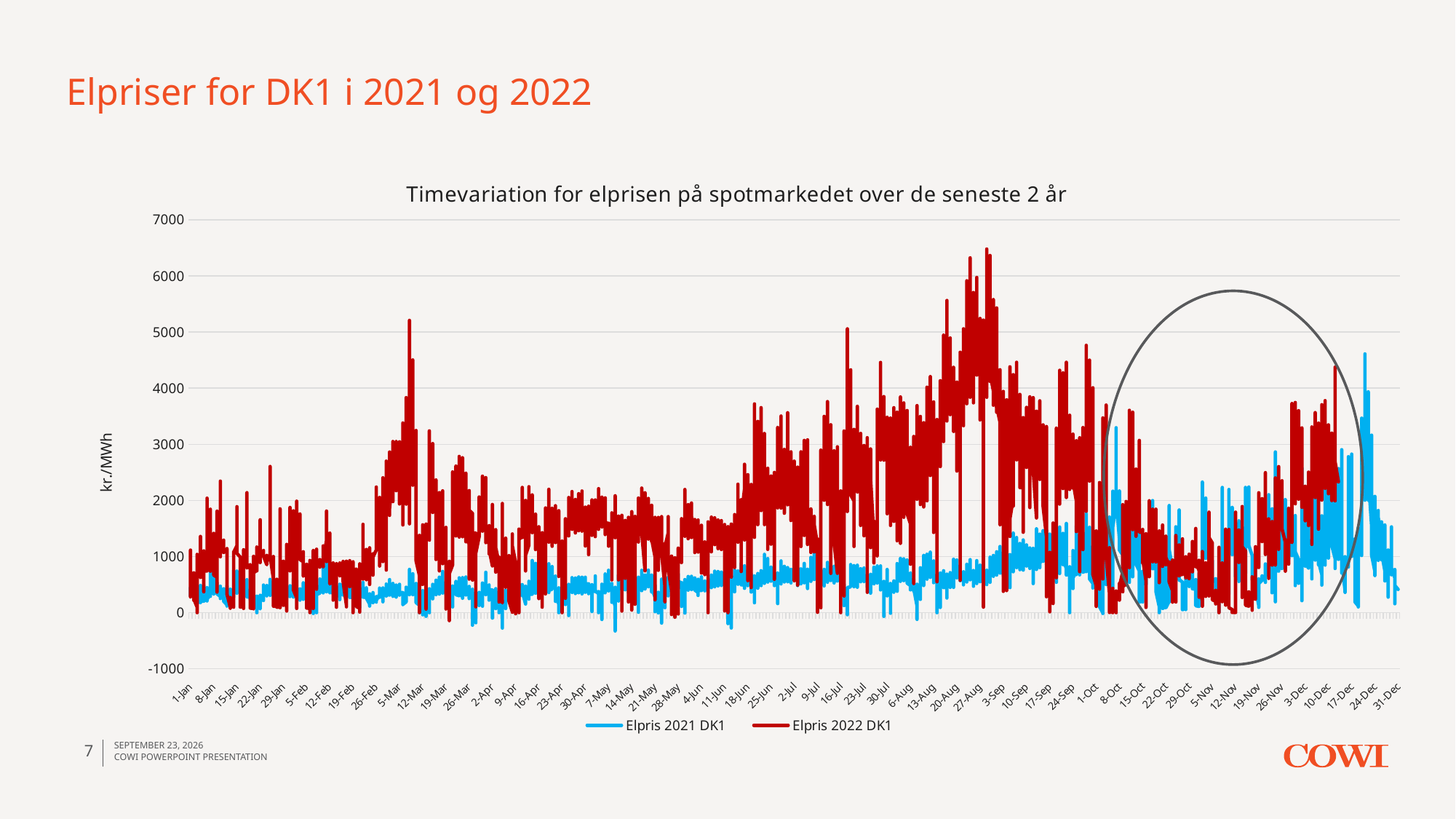
Around 27-Aug, which series has the higher values, Elpris 2021 DK1 or Elpris 2022 DK1? Elpris 2022 DK1 What is the label on the vertical axis? kr./MWh What kind of chart is shown on the slide? Line chart Which series reaches the highest value on the chart, Elpris 2021 DK1 or Elpris 2022 DK1? Elpris 2022 DK1 What is the highest tick value shown on the vertical axis? 7000 How many series does the legend list? 2 Is the highest peak of the Elpris 2021 DK1 series greater or less than 5000? less What are the two series named in the legend? Elpris 2021 DK1 and Elpris 2022 DK1 What is the lowest tick value shown on the vertical axis? -1000 Is the highest peak of the Elpris 2022 DK1 series greater or less than 6000? greater What is the title of the chart? Timevariation for elprisen på spotmarkedet over de seneste 2 år Is the highest peak of the Elpris 2021 DK1 series greater or less than 4000? greater